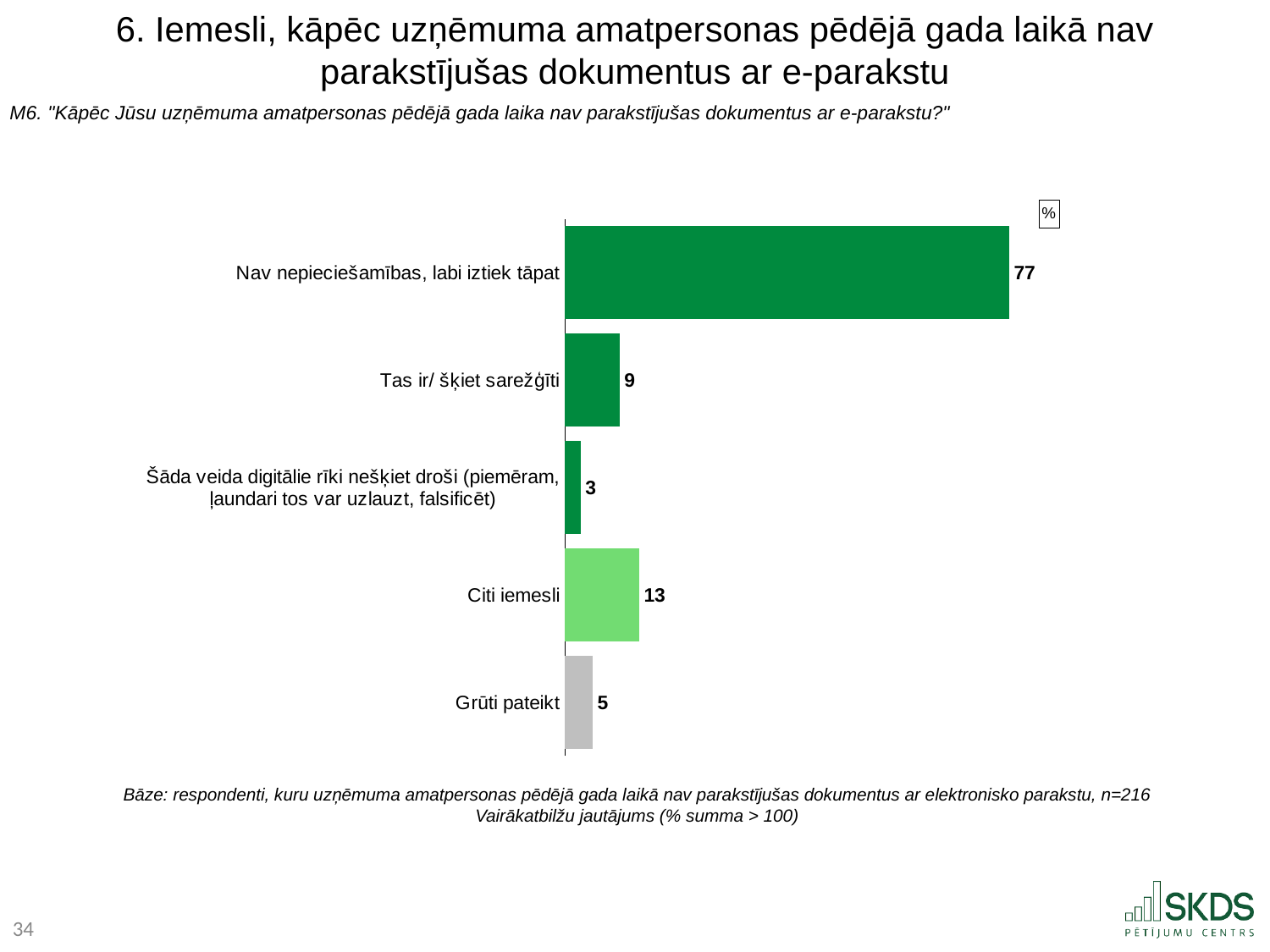
What is the value for "Grūti pateikt"? 5 Which category has the lowest value? Šāda veida digitālie rīki nešķiet droši (piemēram, ļaundari tos var uzlauzt, falsificēt) How many categories are shown in the chart? 5 What kind of chart is shown on the slide? Bar chart What is the value for "Citi iemesli"? 13 What unit label is shown in the box at the top right of the chart? % What is the value for "Tas ir/ šķiet sarežģīti"? 9 What is the difference between the values for "Tas ir/ šķiet sarežģīti" and "Grūti pateikt"? 4 Which is larger: the value for "Tas ir/ šķiet sarežģīti" or the value for "Citi iemesli"? Citi iemesli What is the difference between the values for "Nav nepieciešamības, labi iztiek tāpat" and "Citi iemesli"? 64 What is the value for "Nav nepieciešamības, labi iztiek tāpat"? 77 Which category has the highest value? Nav nepieciešamības, labi iztiek tāpat